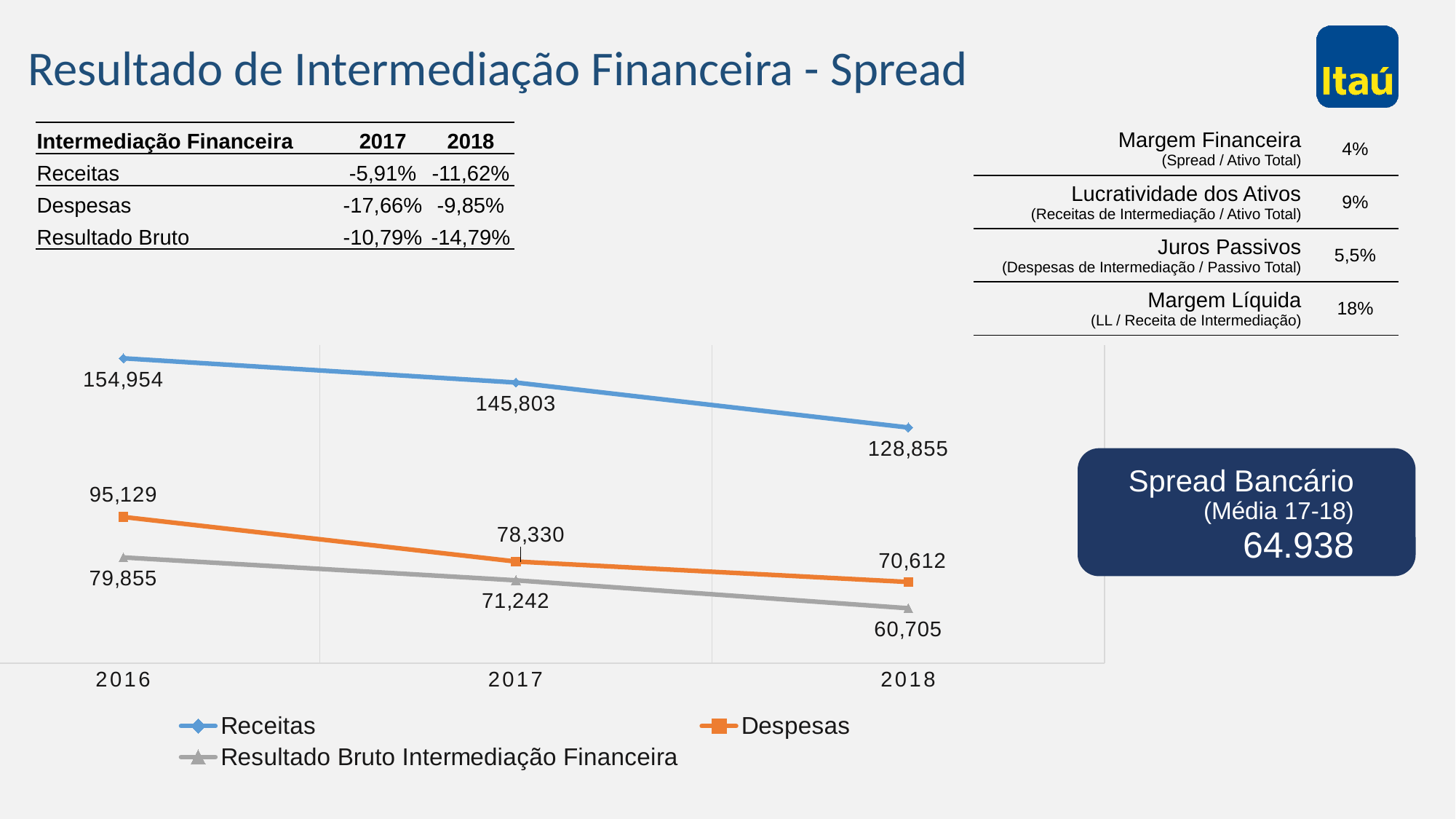
How many series does the chart legend list? 3 In which year is Despesas at its lowest? 2018 In which year is Receitas at its highest? 2016 What type of chart is shown on the slide? line chart How many years are plotted on the x axis of the chart? 3 Do the Receitas values rise or fall from 2016 to 2018? fall What is the value of Resultado Bruto Intermediação Financeira in 2018? 60,705 What is the difference between Receitas in 2016 and Receitas in 2018? 26,099 What is the difference between Receitas and Despesas in 2017? 67,473 What is the value of Receitas in 2016? 154,954 What is the value of Despesas in 2017? 78,330 Which is larger in 2016: Despesas or Resultado Bruto Intermediação Financeira? Despesas